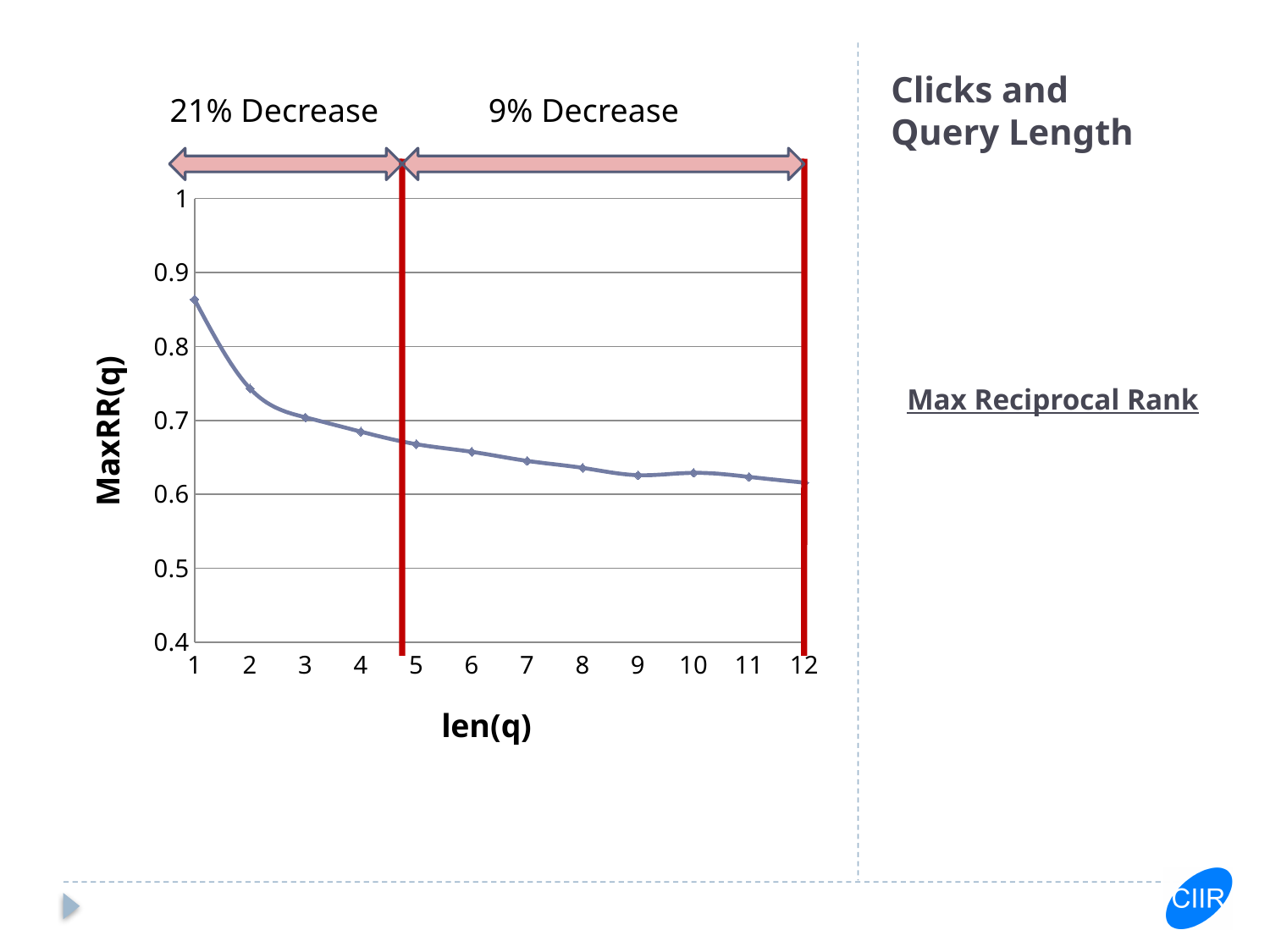
Is the MaxRR(q) value at len(q) = 9 greater or less than 0.7? less How many data points are plotted on the line? 12 What is the label of the x axis? len(q) Is the MaxRR(q) value at len(q) = 1 greater or less than 0.8? greater Is the MaxRR(q) value at len(q) = 12 greater or less than 0.6? greater What kind of chart is shown on the slide? line chart Do the MaxRR(q) values rise or fall as len(q) increases? fall What percentage decrease is annotated above the chart for the range from len(q) = 1 to len(q) = 5? 21% Decrease Which has a higher MaxRR(q) value, len(q) = 1 or len(q) = 12? len(q) = 1 At which len(q) value is MaxRR(q) highest? 1